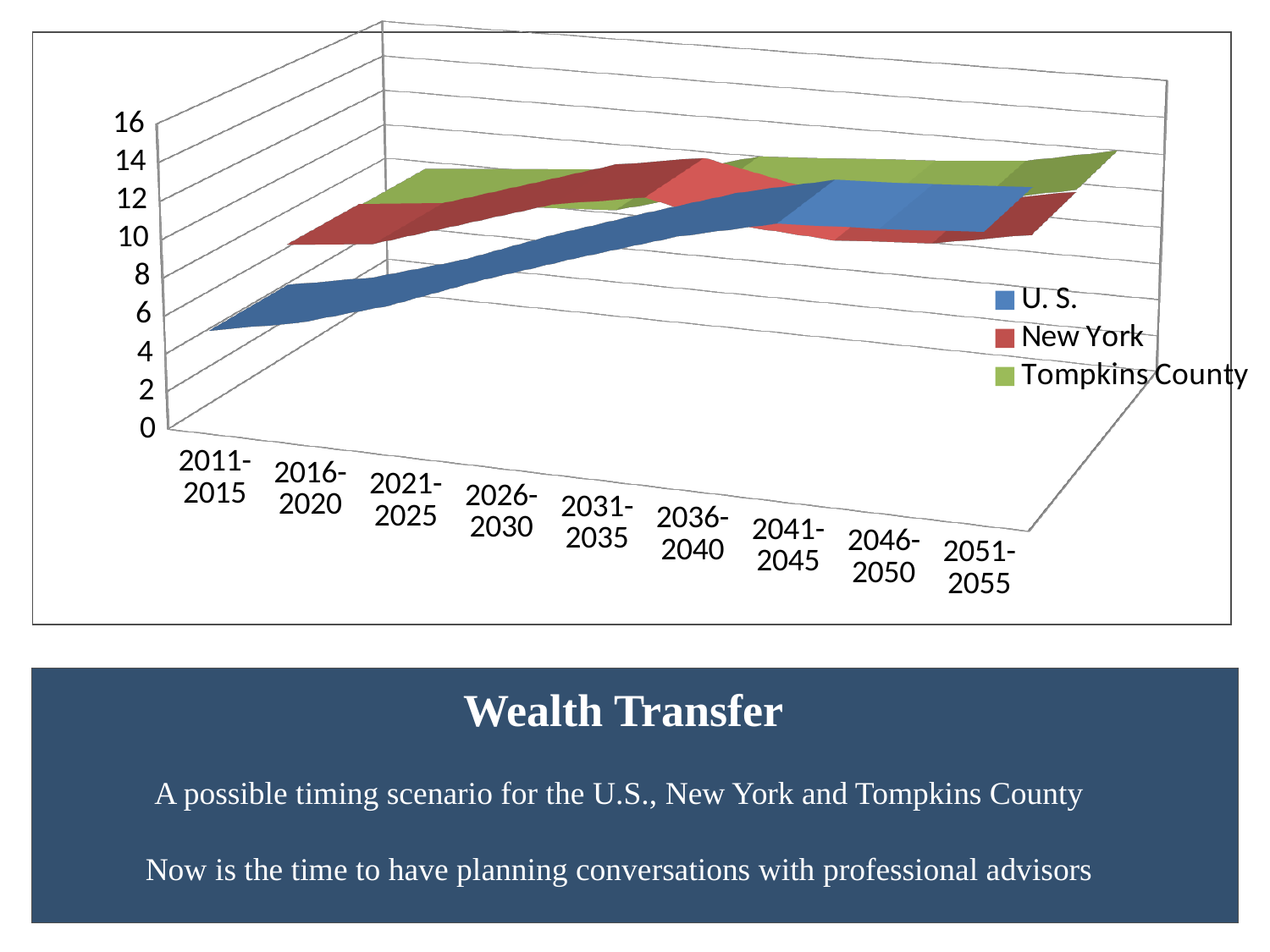
What is the first time period shown on the x axis? 2011-2015 How many series does the chart's legend list? 3 Which colour represents the U. S. series in the chart? Blue How many time periods are shown along the x axis of the chart? 9 Does the U. S. series rise or fall from 2011-2015 to 2041-2045? Rise What are the three series named in the chart's legend? U. S., New York, Tompkins County What is the last time period shown on the x axis? 2051-2055 What is the maximum value shown on the vertical axis of the chart? 16 Is the value for U. S. in 2011-2015 greater or less than 10? less What kind of chart is shown on the slide? 3D line chart